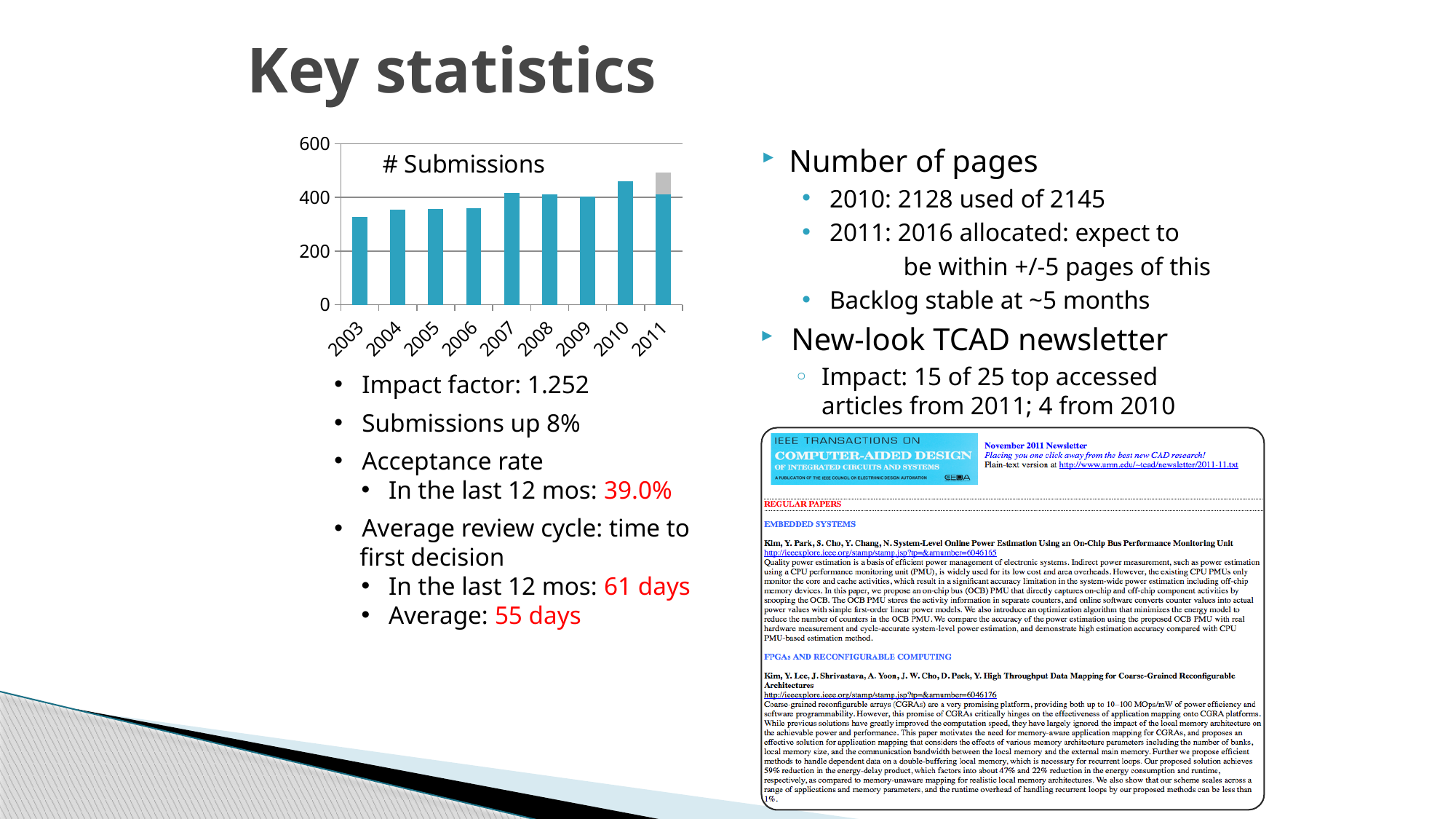
Is the value for 2009 greater or less than 200? greater How many years are shown on the x axis of the chart? 9 Is the value for 2004 greater or less than 400? less Is the value for 2003 greater or less than 400? less Which year has more submissions, 2003 or 2010? 2010 Which year has the lowest number of submissions? 2003 Do the submissions generally rise or fall from 2003 to 2010? rise Which year has more submissions, 2004 or 2007? 2007 What is the title of the chart? # Submissions What kind of chart is shown on the slide? bar chart